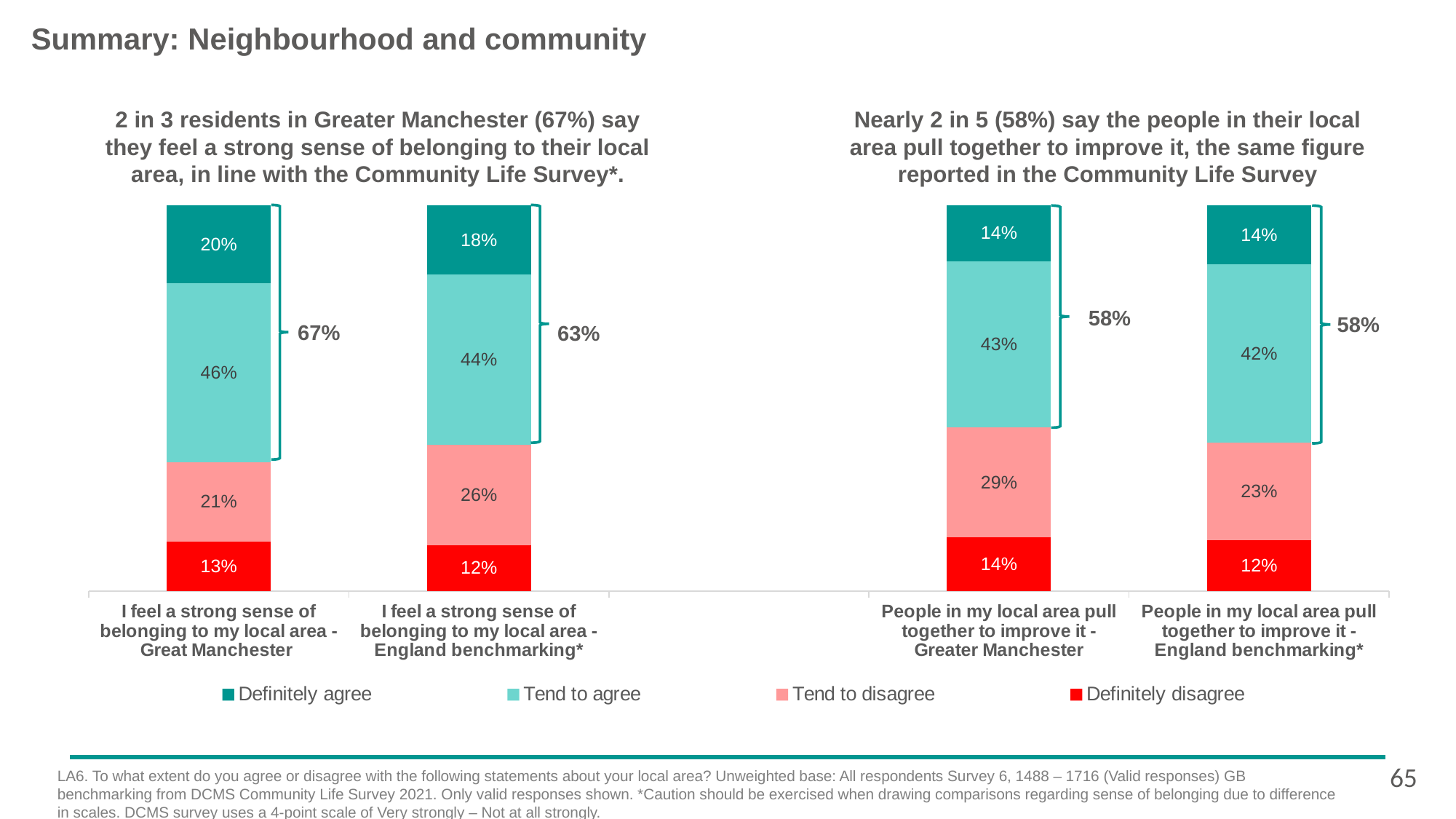
In the left chart, what is the 'Definitely disagree' value for the England benchmarking bar? 12% How many series does the legend list? 4 In the left chart, what percentage of Great Manchester residents 'Tend to agree' that they feel a strong sense of belonging to their local area? 46% What type of chart is used on this slide? Stacked bar chart In the left chart, which bar has the larger 'Definitely agree' value, Great Manchester or England benchmarking? Great Manchester In the left chart, what combined agreement figure is shown by the bracket next to the Great Manchester bar? 67% In the left chart, what is the difference between the 'Tend to disagree' values for England benchmarking and Great Manchester? 5% In the right chart, what is the 'Tend to disagree' value for the Greater Manchester bar? 29% In the left chart, what is the total of the Great Manchester stacked bar? 100% In the right chart, what is the difference between the 'Tend to disagree' values for Greater Manchester and England benchmarking? 6% In the right chart, which bar has the larger 'Definitely disagree' value, Greater Manchester or England benchmarking? Greater Manchester In the right chart, what is the 'Definitely agree' value for the England benchmarking bar? 14%